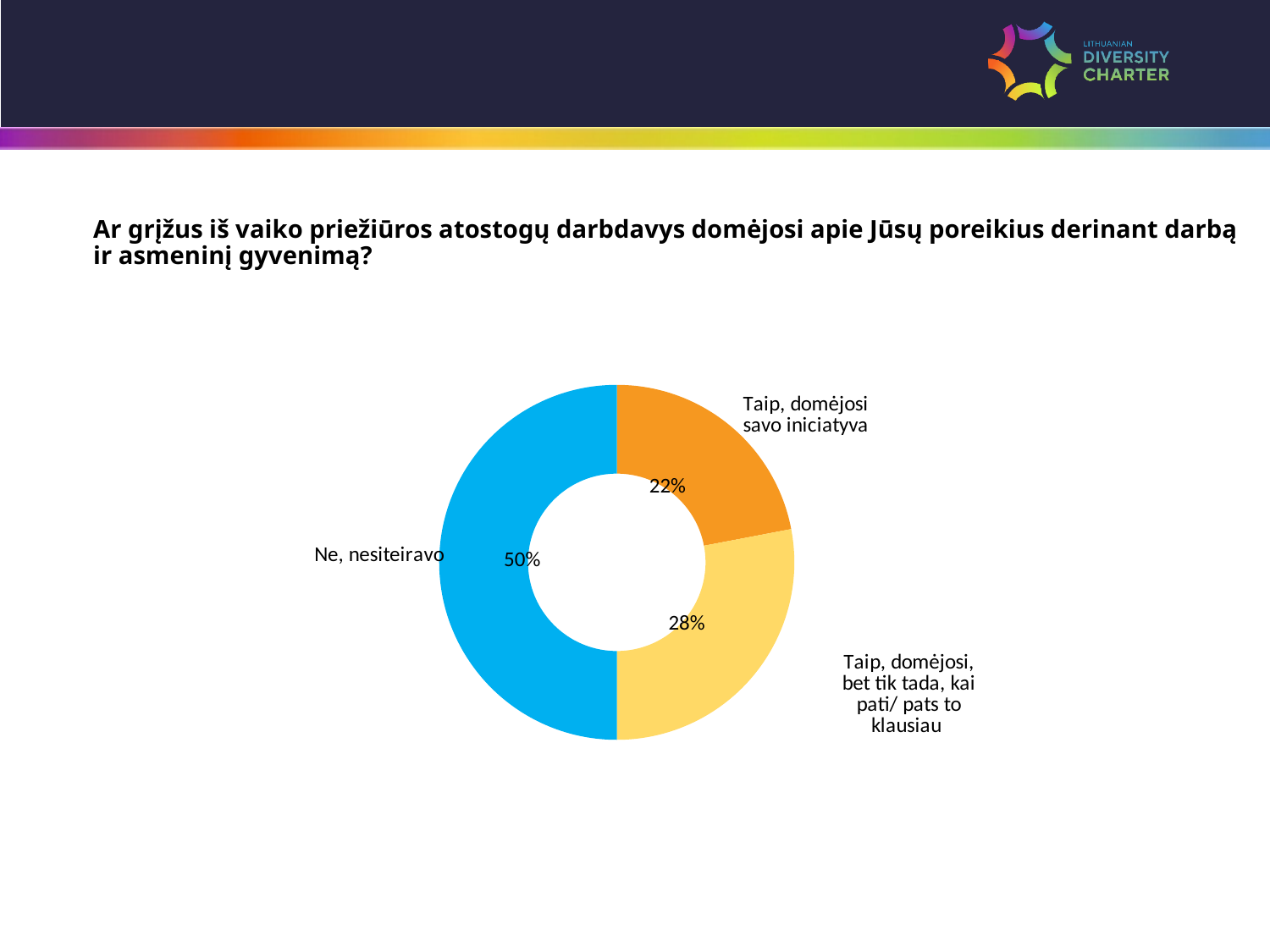
Which is larger: the share for "Taip, domėjosi savo iniciatyva" or for "Taip, domėjosi, bet tik tada, kai pati/ pats to klausiau"? Taip, domėjosi, bet tik tada, kai pati/ pats to klausiau What is the value for "Taip, domėjosi, bet tik tada, kai pati/ pats to klausiau"? 28% How many categories are shown in the chart? 3 Which category has the largest share? Ne, nesiteiravo What colour is the segment for "Ne, nesiteiravo"? Blue What kind of chart is shown on the slide? Doughnut chart What is the value for "Taip, domėjosi savo iniciatyva"? 22% What is the difference between the shares for "Taip, domėjosi, bet tik tada, kai pati/ pats to klausiau" and "Taip, domėjosi savo iniciatyva"? 6% What is the difference between the shares for "Ne, nesiteiravo" and "Taip, domėjosi savo iniciatyva"? 28% What share of the chart does "Ne, nesiteiravo" represent? 50% What is the combined share of the two "Taip" categories? 50% Which category has the smallest share? Taip, domėjosi savo iniciatyva